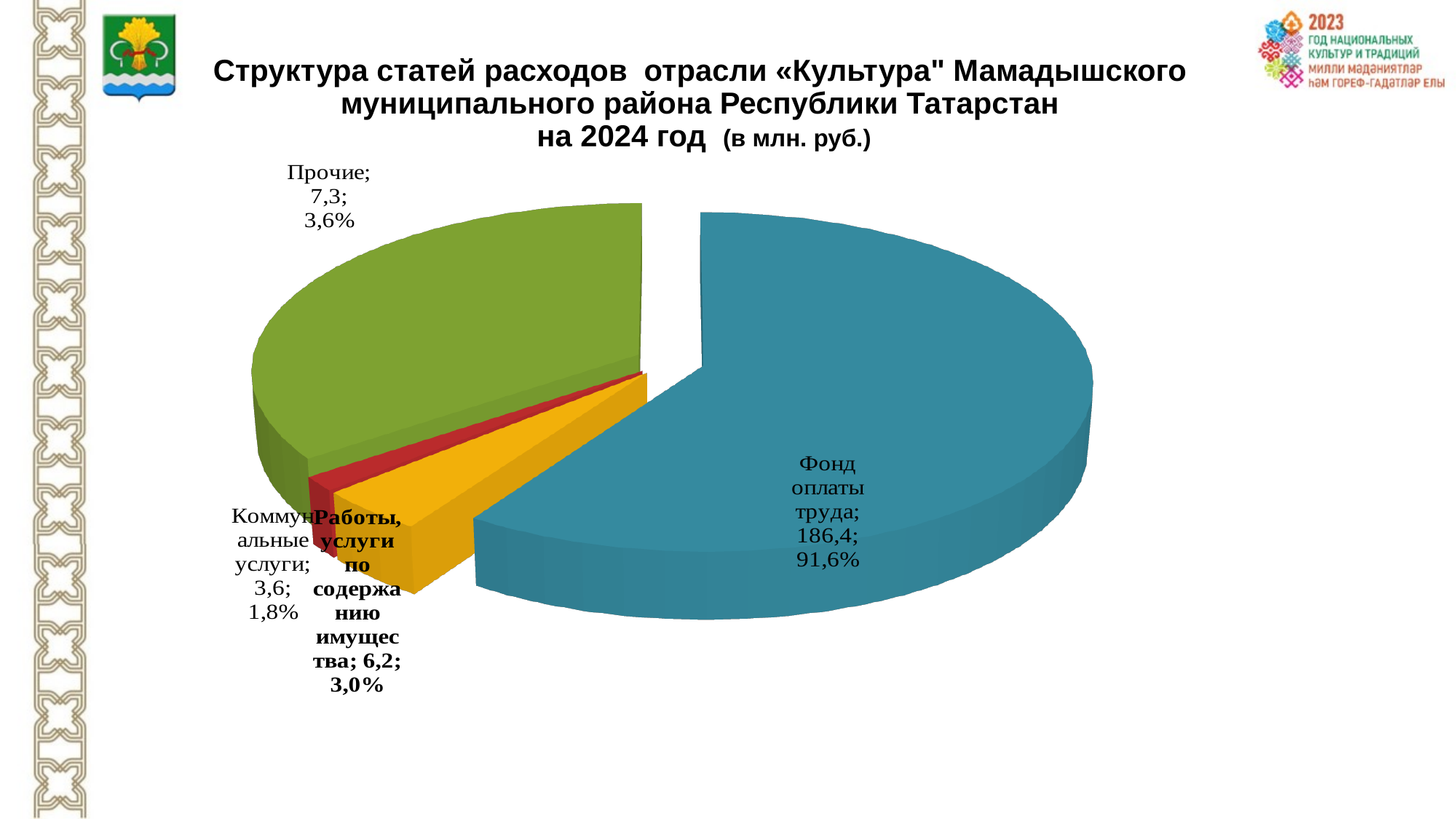
What is the difference between the values for Прочие and Работы, услуги по содержанию имущества? 1,1 Which is larger, the value for Прочие or the value for Коммунальные услуги? Прочие Which category has the largest slice? Фонд оплаты труда How many slices does the pie chart have? 4 What share of the pie does Коммунальные услуги represent? 1,8% What is the value for Работы, услуги по содержанию имущества? 6,2 Which category has the smallest slice? Коммунальные услуги What is the value for Прочие? 7,3 What share of the pie does Фонд оплаты труда represent? 91,6% What kind of chart is shown on the slide? Pie chart What is the value for Фонд оплаты труда? 186,4 In what units are the values on the chart given, according to the title? млн. руб.